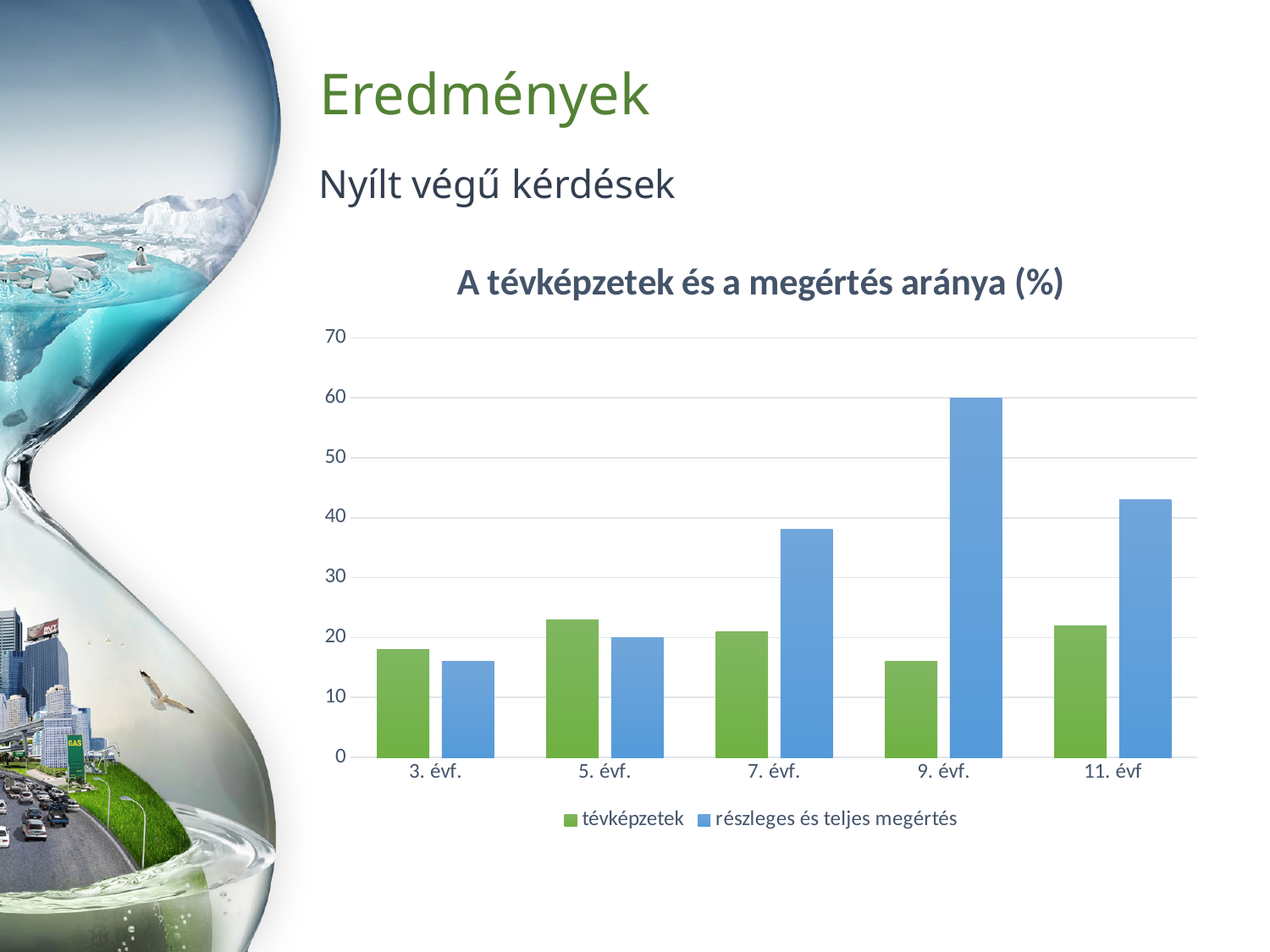
Is the value for 'részleges és teljes megértés' at 11. évf greater or less than 50? less What kind of chart is shown on the slide? bar chart Which grade has the highest value for 'részleges és teljes megértés'? 9. évf. Which grade has the lowest value for 'részleges és teljes megértés'? 3. évf. Which colour represents the 'részleges és teljes megértés' series? blue How many grade categories are shown on the x axis? 5 At 3. évf., which is larger: 'tévképzetek' or 'részleges és teljes megértés'? tévképzetek What is the title of the chart? A tévképzetek és a megértés aránya (%) How many series does the legend list? 2 Is the value for 'tévképzetek' at 5. évf. greater or less than 20? greater At 7. évf., which is larger: 'tévképzetek' or 'részleges és teljes megértés'? részleges és teljes megértés What is the value for 'részleges és teljes megértés' at 9. évf.? 60